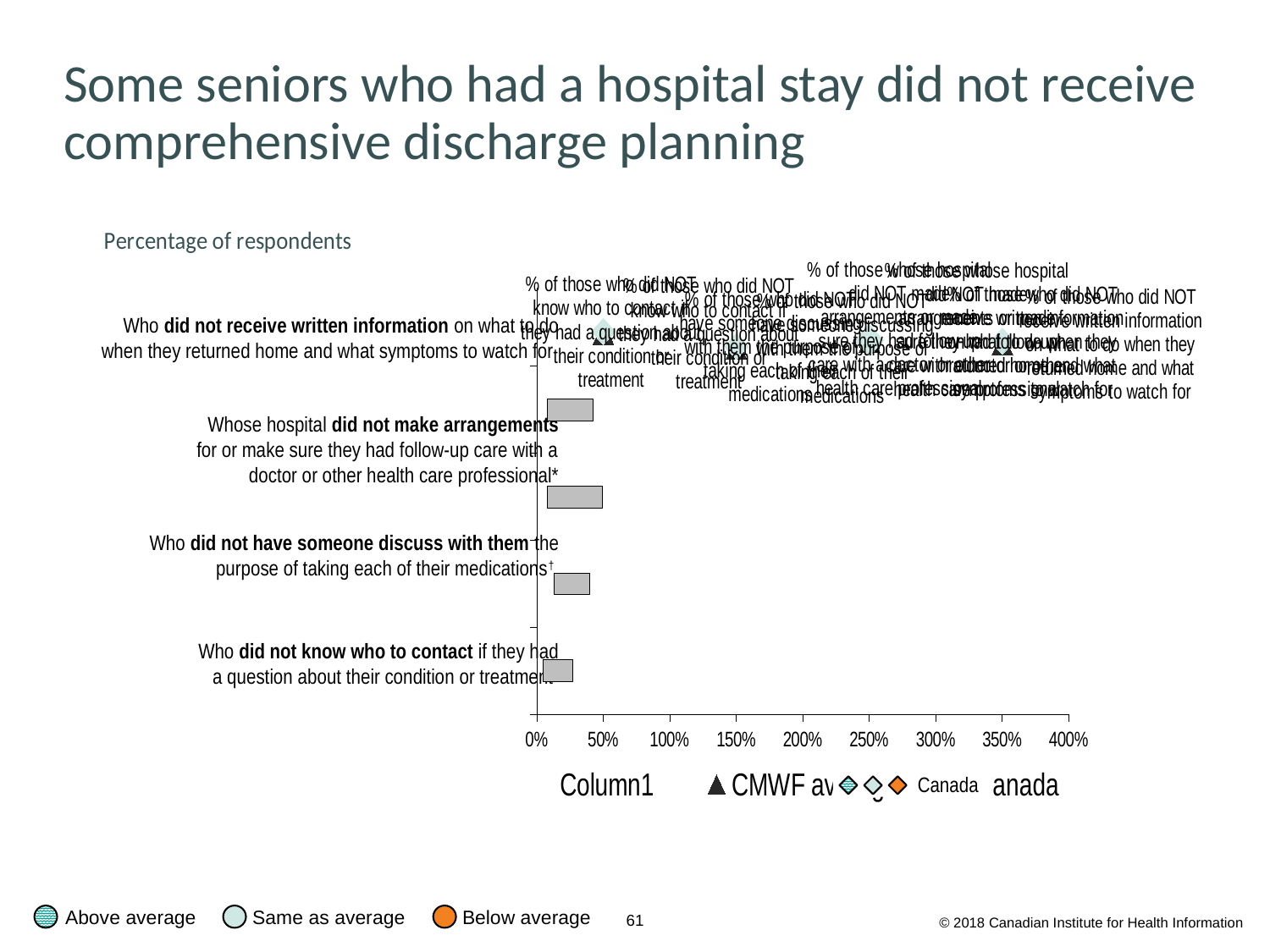
Is the value for 'Who did not have someone discuss with them the purpose of taking each of their medications' greater or less than 50%? less What kind of chart is shown on the slide? bar chart Which is larger: the value for 'Who did not have someone discuss with them the purpose of taking each of their medications' or the value for 'Who did not know who to contact if they had a question about their condition or treatment'? Who did not have someone discuss with them the purpose of taking each of their medications What is the title of the slide containing the chart? Some seniors who had a hospital stay did not receive comprehensive discharge planning Is the value for 'Who did not know who to contact if they had a question about their condition or treatment' greater or less than 50%? less Which is larger: the value for 'Whose hospital did not make arrangements for or make sure they had follow-up care with a doctor or other health care professional' or the value for 'Who did not know who to contact if they had a question about their condition or treatment'? Whose hospital did not make arrangements for or make sure they had follow-up care with a doctor or other health care professional Which category has the shortest bar? Who did not know who to contact if they had a question about their condition or treatment What is the highest value shown on the x axis of the chart? 400% Is the value for 'Who did not receive written information on what to do when they returned home and what symptoms to watch for' greater or less than 100%? less How many categories (bars) does the chart show? 4